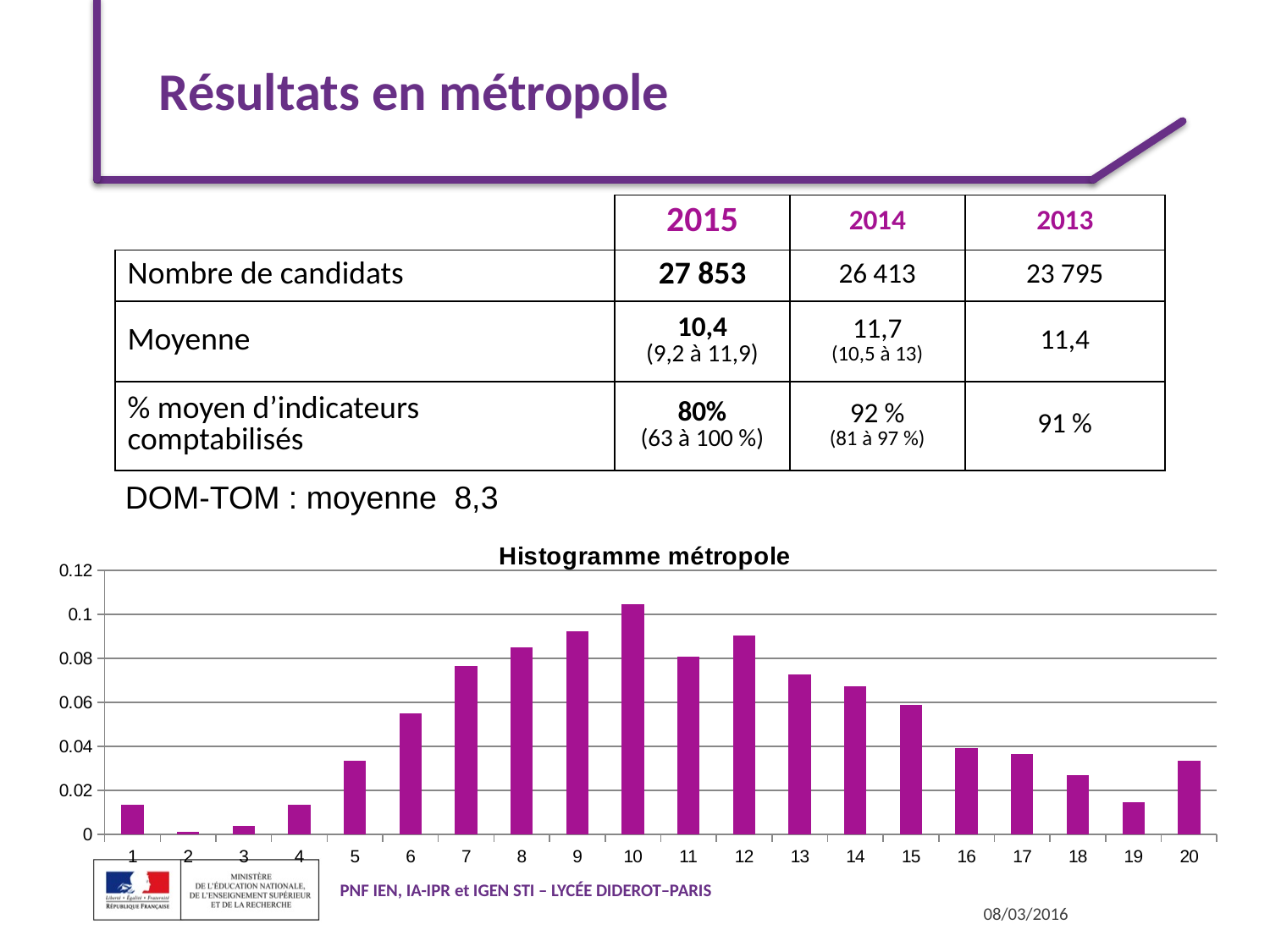
How many categories are shown on the x axis of the chart? 20 Which category has the highest bar in the chart? 10 Which category has the lowest bar in the chart? 2 Is the value for category 9 greater or less than 0.08? greater Do the values rise or fall from category 4 to category 10? rise Which has the larger value, category 8 or category 14? 8 Is the value for category 18 greater or less than 0.02? greater What kind of chart is shown on the slide? bar chart Is the value for category 10 greater or less than 0.1? greater Which has the larger value, category 19 or category 20? 20 What is the title of the chart on the slide? Histogramme métropole